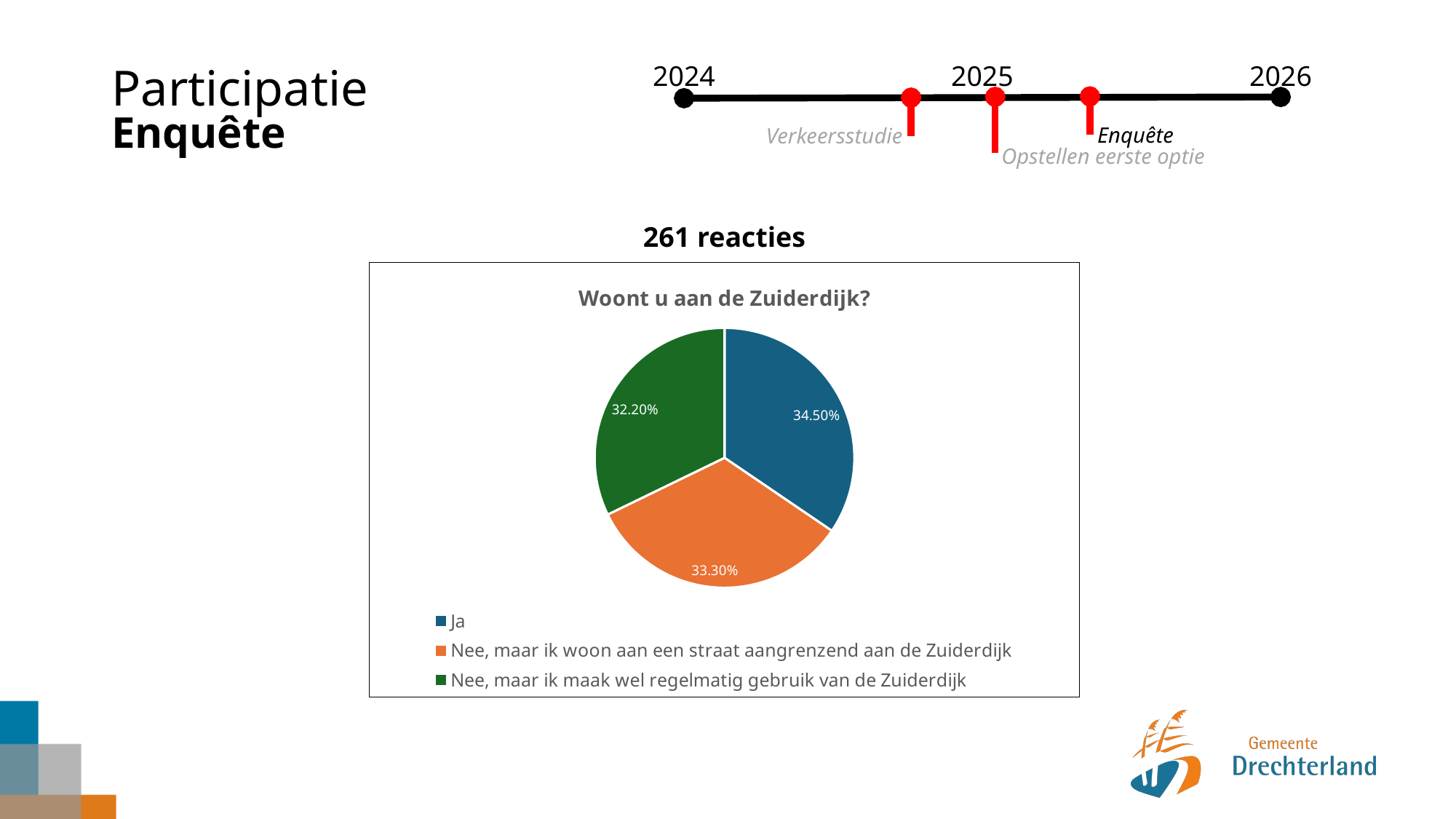
What is the title of the chart? Woont u aan de Zuiderdijk? How many responses (reacties) does the slide say the survey received? 261 Which colour represents the "Ja" category in the pie chart? blue How many categories does the pie chart show? 3 What percentage of respondents answered "Ja"? 34.50% How many entries does the legend list? 3 What kind of chart is shown on the slide? pie chart What percentage of respondents answered "Nee, maar ik woon aan een straat aangrenzend aan de Zuiderdijk"? 33.30% Which answer category has the smallest share of the pie? Nee, maar ik maak wel regelmatig gebruik van de Zuiderdijk Which answer category has the largest share of the pie? Ja What percentage of respondents answered "Nee, maar ik maak wel regelmatig gebruik van de Zuiderdijk"? 32.20% What is the difference in percentage points between the "Ja" slice and the "Nee, maar ik maak wel regelmatig gebruik van de Zuiderdijk" slice? 2.30%